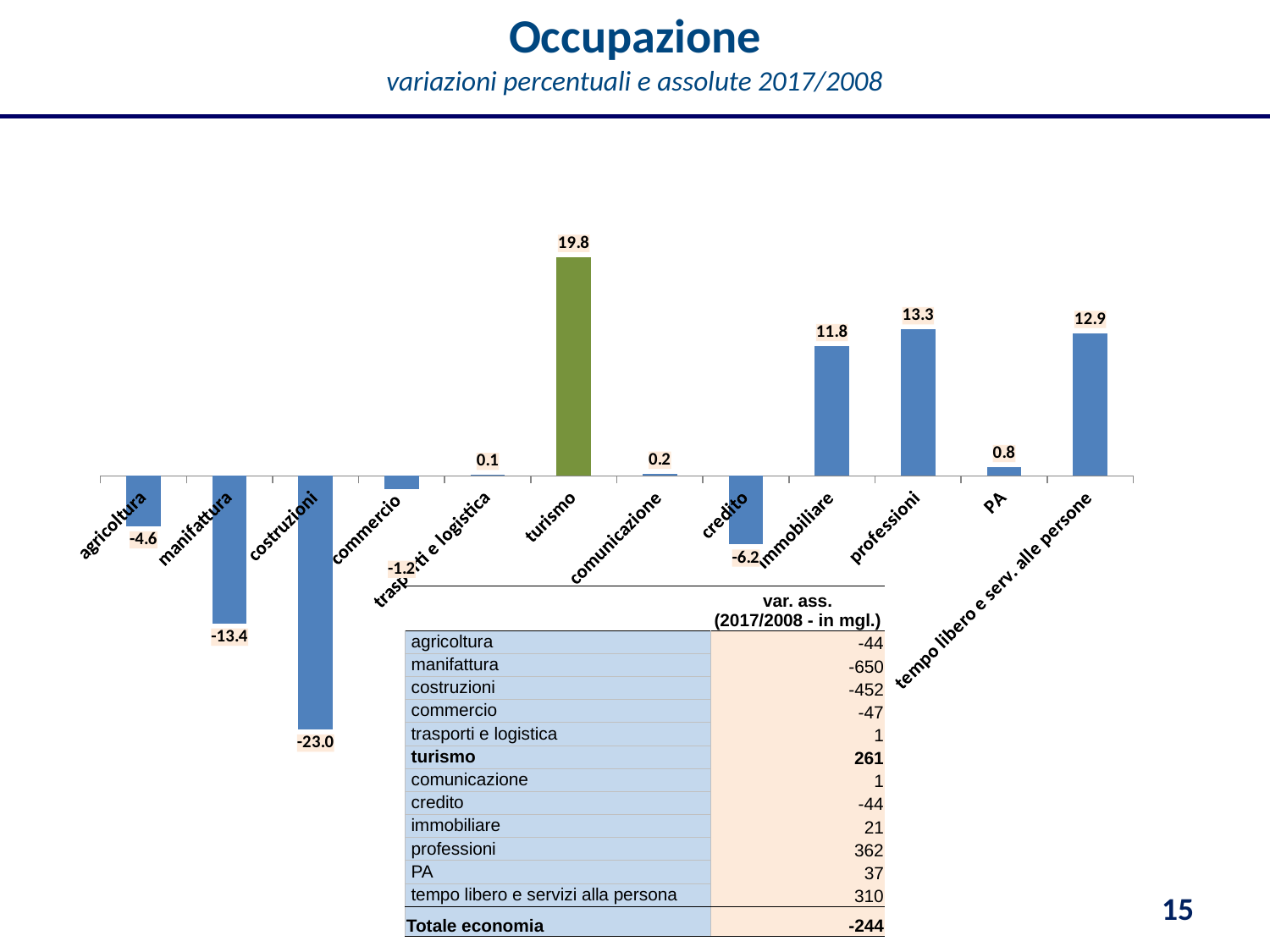
What is the value shown for turismo in the bar chart? 19.8 What is the value shown for credito in the bar chart? -6.2 What is the value shown for professioni in the bar chart? 13.3 Which category has the lowest value in the bar chart? costruzioni Which category has the highest value in the bar chart? turismo What type of chart is shown on the slide? bar chart What is the value shown for manifattura in the bar chart? -13.4 Which is larger in the bar chart, the value for immobiliare or the value for tempo libero e serv. alle persone? tempo libero e serv. alle persone Which bar in the chart is coloured green rather than blue? turismo What is the difference between the values for turismo and professioni in the bar chart? 6.5 How many categories are plotted in the bar chart? 12 What is the value shown for costruzioni in the bar chart? -23.0